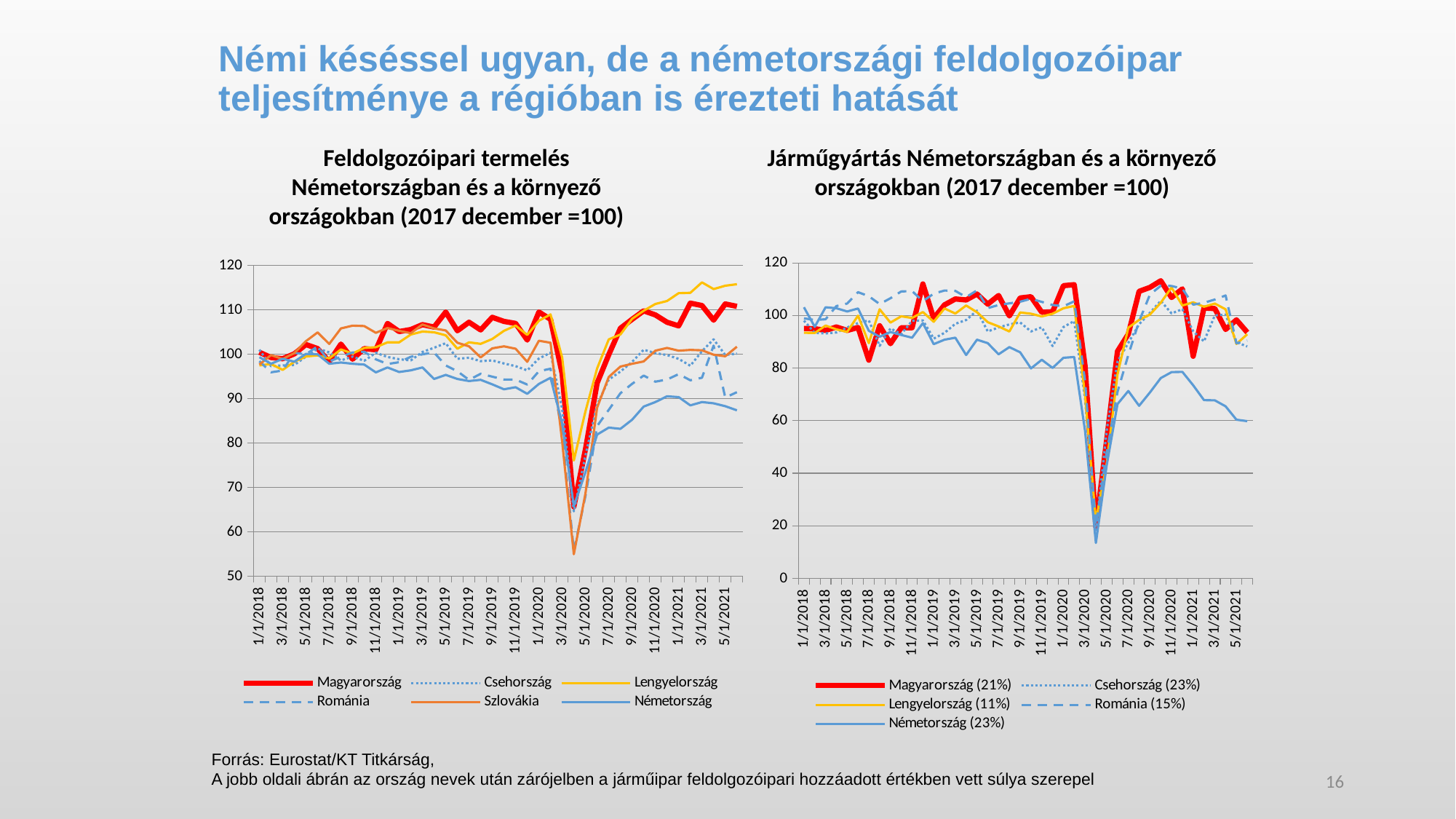
How many series does the legend of the left chart (Feldolgozóipari termelés) list? 6 In the right chart (Járműgyártás), what percentage is shown in parentheses after Csehország in the legend? 23% How many series does the legend of the right chart (Járműgyártás) list? 5 What kind of chart is the left chart, 'Feldolgozóipari termelés Németországban és a környező országokban'? line chart In the left chart (Feldolgozóipari termelés), is the value for Németország at 5/1/2021 greater or less than 90? less In the left chart (Feldolgozóipari termelés), is the lowest value of Szlovákia in spring 2020 greater or less than 60? less In the right chart (Járműgyártás), is the lowest value for Németország in spring 2020 greater or less than 20? less In the right chart (Járműgyártás), does the Németország line rise or fall between 9/1/2020 and 5/1/2021? fall In the right chart (Járműgyártás), what percentage is shown in parentheses after Lengyelország in the legend? 11% In the left chart (Feldolgozóipari termelés), which is higher at 5/1/2021: Lengyelország or Németország? Lengyelország